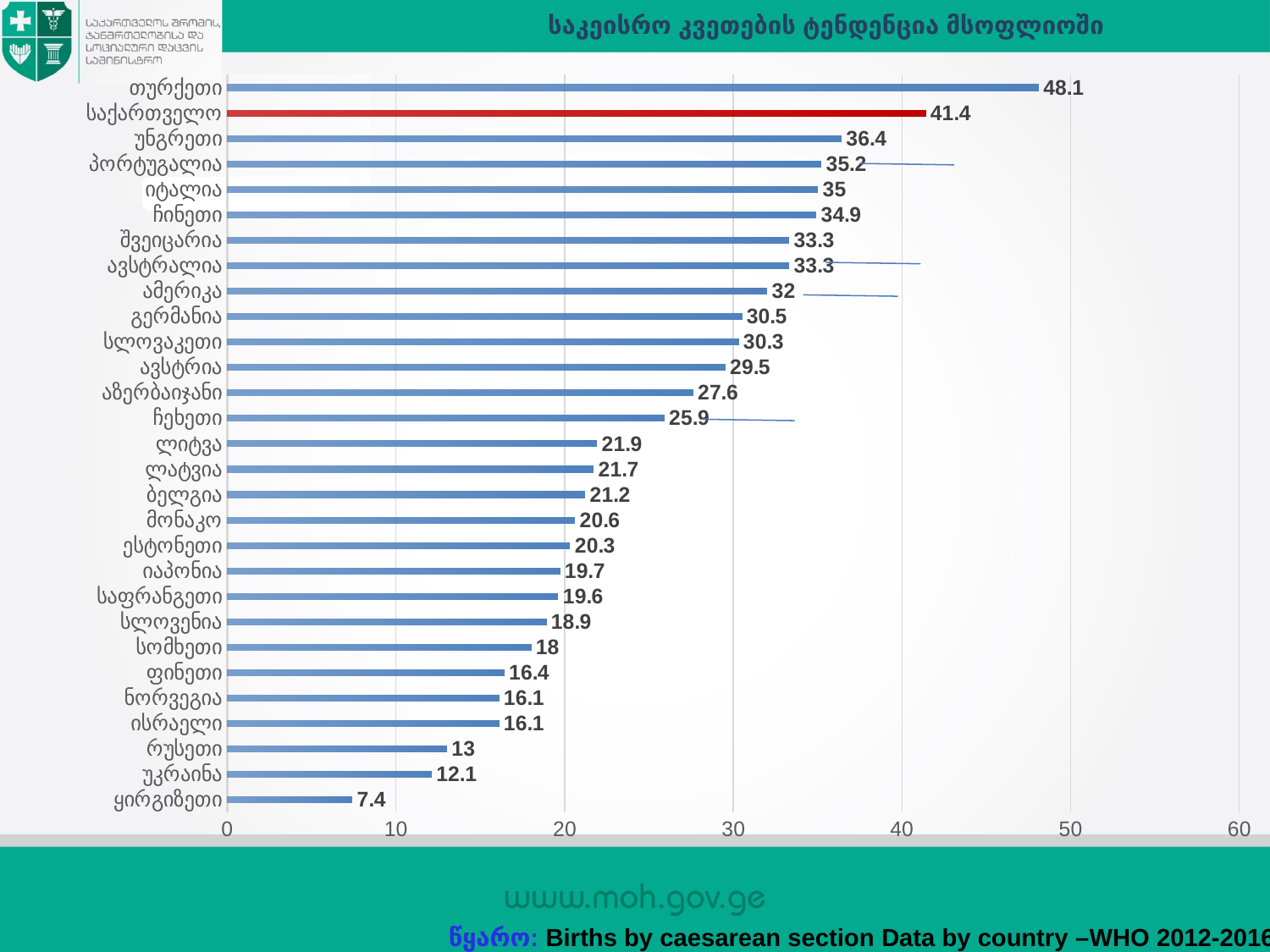
Which country has the lowest value? ყირგიზეთი How many countries are shown in the chart? 29 Which country has the highest value? თურქეთი Which bar is highlighted in red? საქართველო What is the value for საქართველო? 41.4 What is the value for ჩინეთი? 34.9 What kind of chart is shown on the slide? bar chart Is the value for ამერიკა greater or less than 30? greater What is the difference between the values for თურქეთი and საქართველო? 6.7 Which has a larger value, გერმანია or ავსტრია? გერმანია What is the value for ყირგიზეთი? 7.4 What is the difference between the values for უკრაინა and რუსეთი? 0.9